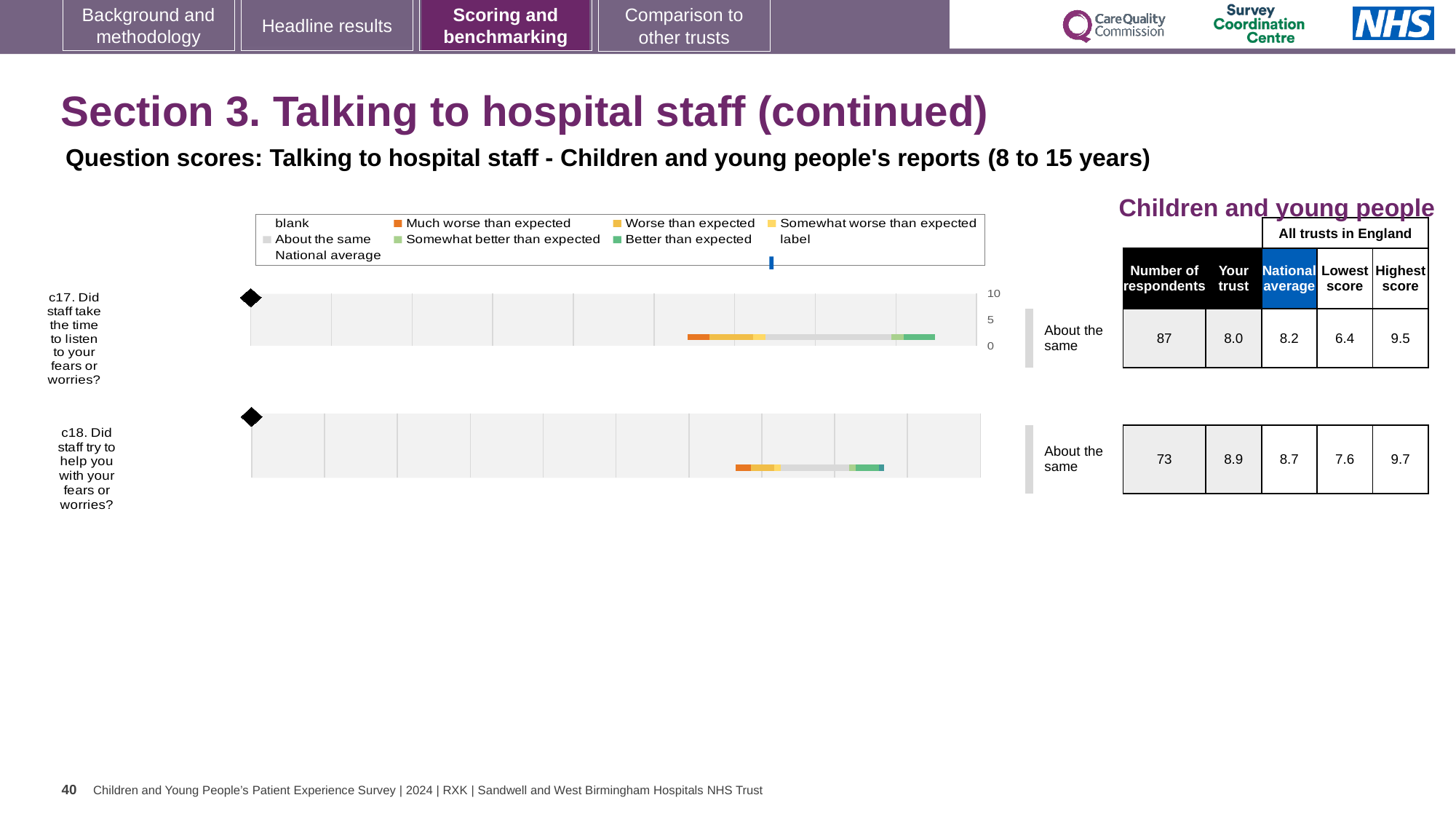
What is the difference between the highest score and the lowest score for c17? 3.1 Is the 'Your trust' score for c17 greater or less than 5? greater How many questions are plotted on the slide? 2 By how much does the 'Your trust' score for c18 exceed the national average? 0.2 What benchmark category label is shown next to the c17 chart? About the same For c18, which is larger: the 'Your trust' score or the national average? Your trust What is the national average score for c18 (Did staff try to help you with your fears or worries?)? 8.7 Which question, c17 or c18, has the higher 'Your trust' score? c18 How many respondents answered question c17? 87 What is the lowest score among all trusts in England for c18? 7.6 What kind of chart is used to show the question scores? Bar chart What is the 'Your trust' score for c17 (Did staff take the time to listen to your fears or worries?)? 8.0